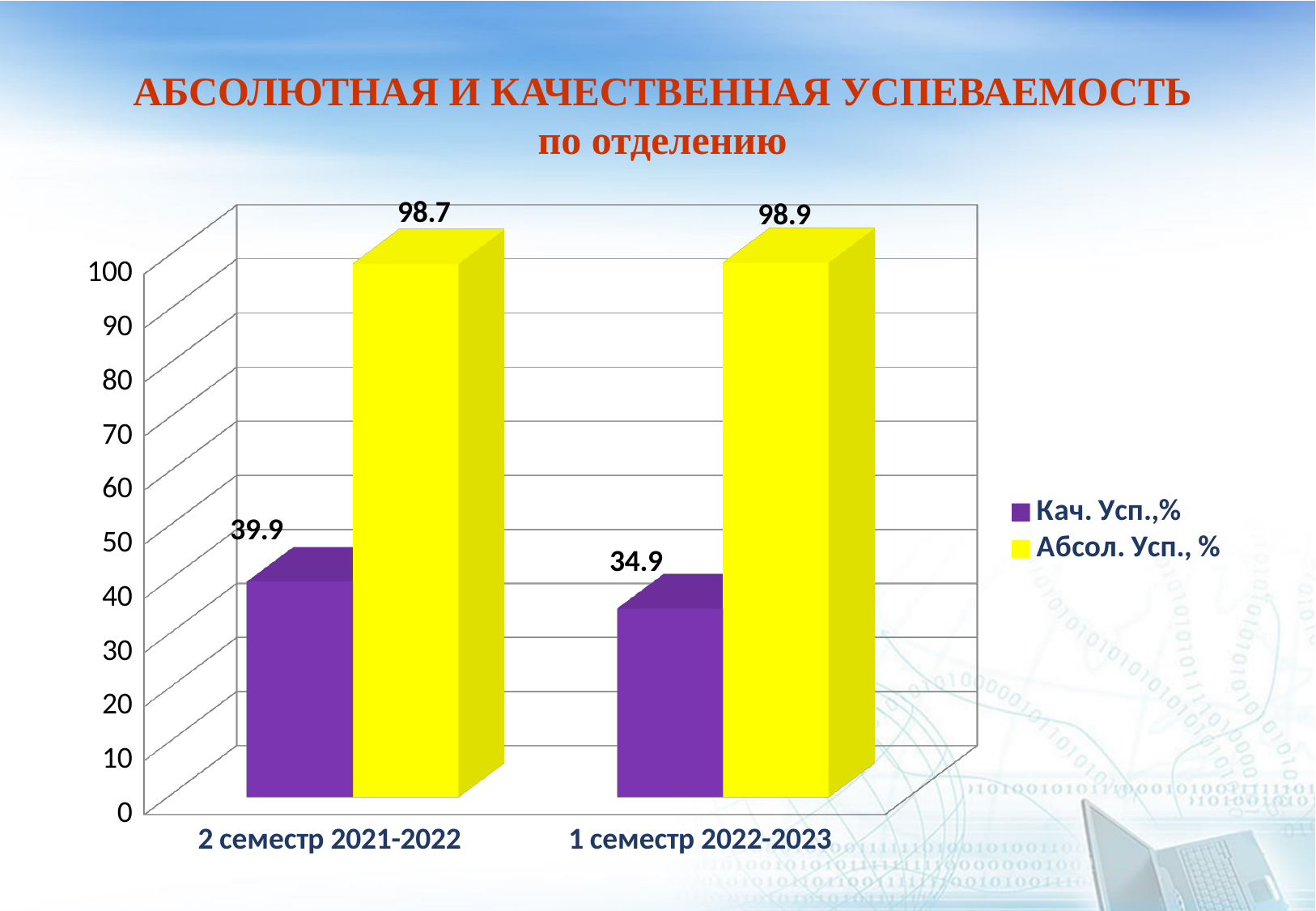
What is the value of Абсол. Усп., % for 1 семестр 2022-2023? 98.9 What is the value of Кач. Усп.,% for 2 семестр 2021-2022? 39.9 How many series does the legend list? 2 Is the Кач. Усп.,% value for 2 семестр 2021-2022 greater or less than 50? less How many categories are shown on the x axis? 2 Which colour represents the Абсол. Усп., % series? yellow Which semester has the higher Кач. Усп.,% value? 2 семестр 2021-2022 What is the value of Кач. Усп.,% for 1 семестр 2022-2023? 34.9 What is the difference between the Кач. Усп.,% values for 2 семестр 2021-2022 and 1 семестр 2022-2023? 5 What is the value of Абсол. Усп., % for 2 семестр 2021-2022? 98.7 Which semester has the lower Кач. Усп.,% value? 1 семестр 2022-2023 What kind of chart is shown on the slide? bar chart